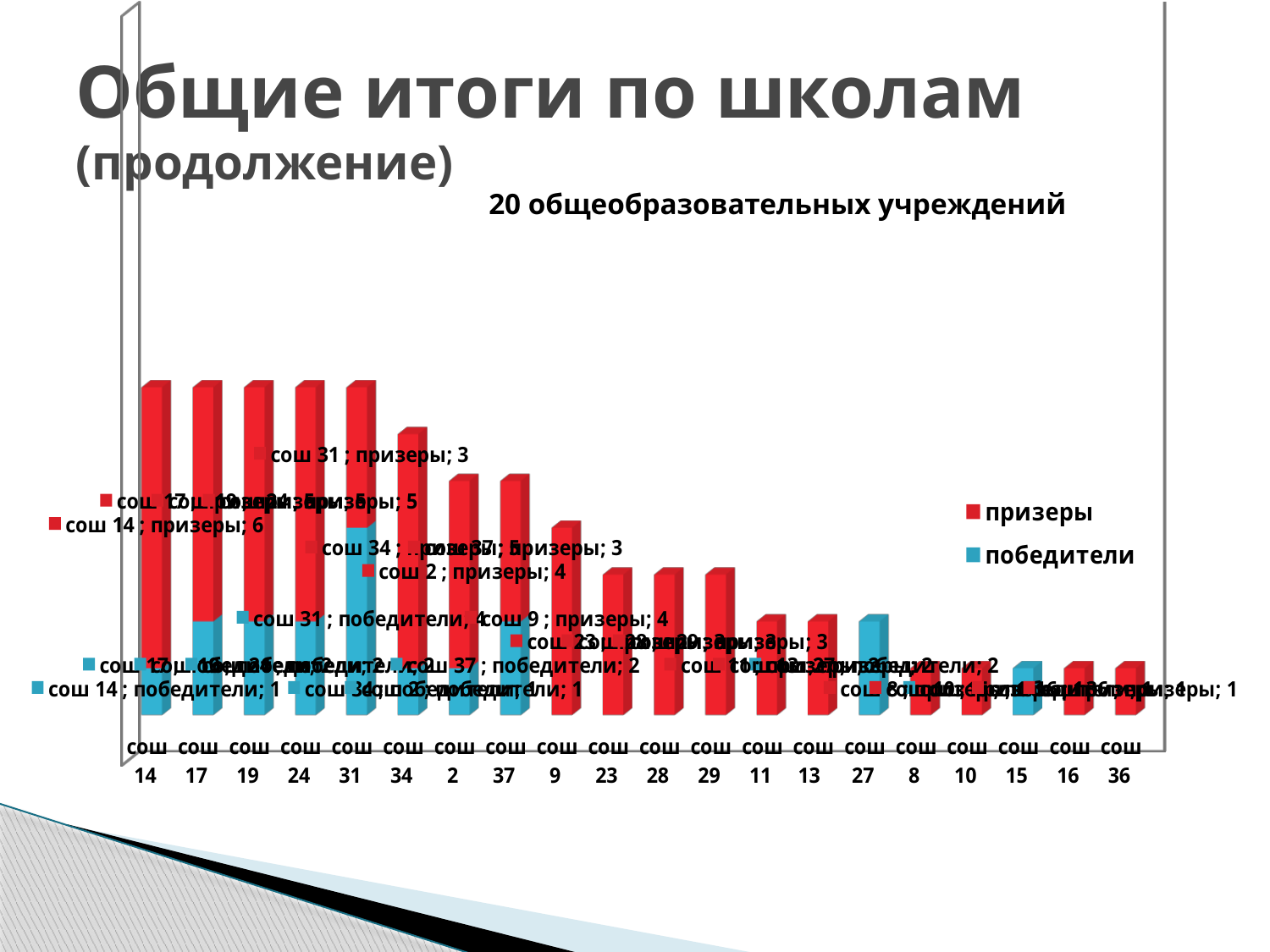
What is the value of 'победители' for сош 31? 4 What is the title of the chart? 20 общеобразовательных учреждений What is the difference between 'призеры' and 'победители' for сош 14? 5 What is the total of the stacked bar for сош 14 (призеры plus победители)? 7 Do the bar heights generally rise or fall from left to right along the x axis? fall Which colour represents the series 'призеры' in the chart? red How many series does the chart legend list? 2 What is the value of 'победители' for сош 14? 1 What is the value of 'призеры' for сош 2? 4 What is the value of 'призеры' for сош 14? 6 What kind of chart is shown on the slide? bar chart How many schools (categories) are shown along the x axis of the chart? 20